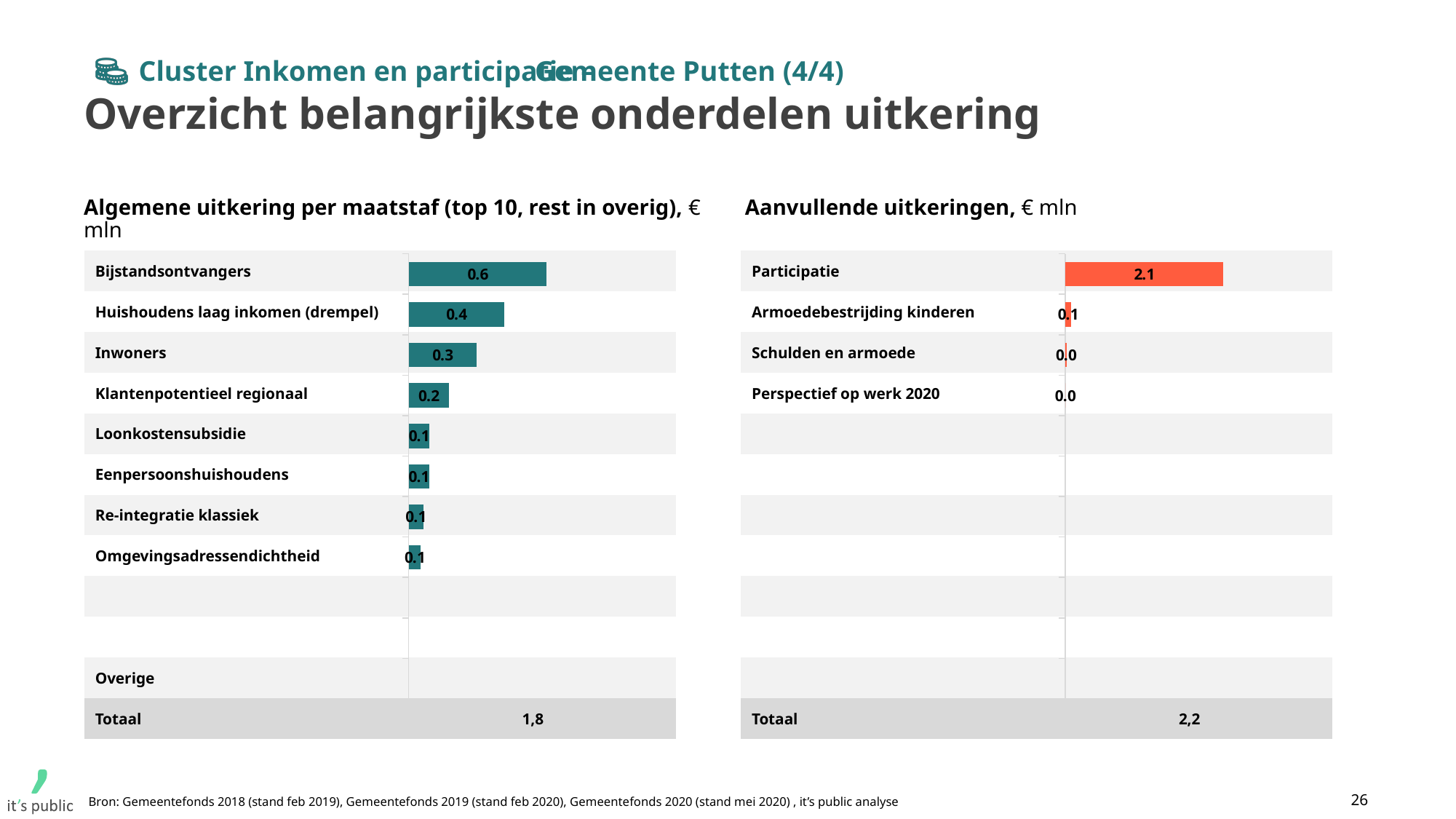
In the right chart (Aanvullende uitkeringen), which category has the highest value? Participatie In the left chart (Algemene uitkering per maatstaf), which is larger: Inwoners or Klantenpotentieel regionaal? Inwoners In the right chart (Aanvullende uitkeringen), what is the value for Armoedebestrijding kinderen? 0.1 In the right chart (Aanvullende uitkeringen), how many categories are plotted? 4 In the right chart (Aanvullende uitkeringen), what is the value for Participatie? 2.1 In the left chart (Algemene uitkering per maatstaf), what is the difference between Bijstandsontvangers and Klantenpotentieel regionaal? 0.4 What kind of chart is the right chart (Aanvullende uitkeringen)? Bar chart In the left chart (Algemene uitkering per maatstaf), which category has the highest value? Bijstandsontvangers In the left chart (Algemene uitkering per maatstaf), what is the value for Huishoudens laag inkomen (drempel)? 0.4 In the left chart (Algemene uitkering per maatstaf), what is the Totaal shown at the bottom? 1,8 In the left chart (Algemene uitkering per maatstaf), what is the value for Inwoners? 0.3 In the left chart (Algemene uitkering per maatstaf), what is the value for Bijstandsontvangers? 0.6